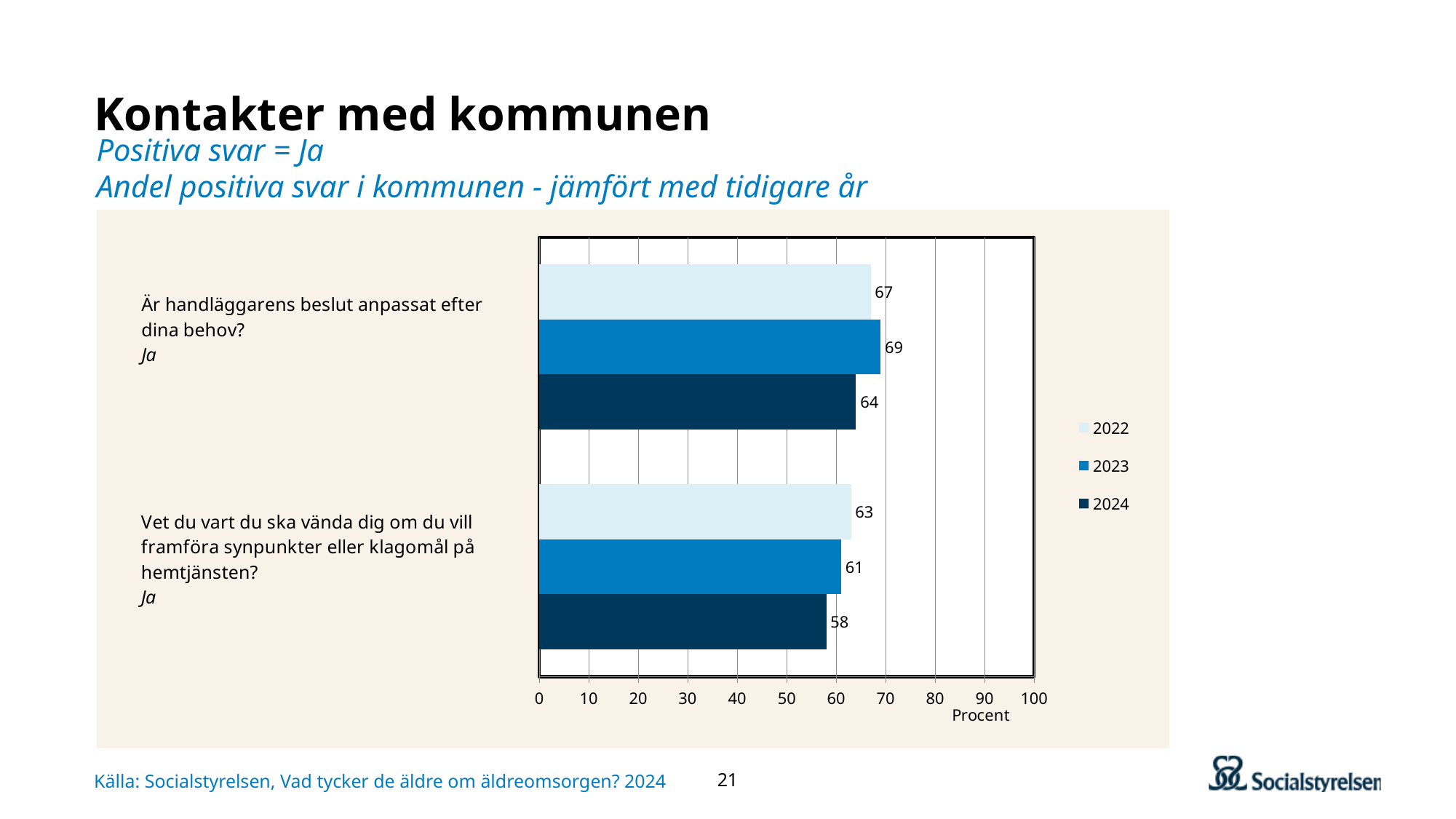
Which year has the lowest value for "Vet du vart du ska vända dig om du vill framföra synpunkter eller klagomål på hemtjänsten?"? 2024 What is the label on the horizontal axis of the chart? Procent What is the 2023 value for "Är handläggarens beslut anpassat efter dina behov?"? 69 What is the 2024 value for "Är handläggarens beslut anpassat efter dina behov?"? 64 What is the 2022 value for "Vet du vart du ska vända dig om du vill framföra synpunkter eller klagomål på hemtjänsten?"? 63 How many series does the legend list? 3 What is the difference between the 2022 and 2024 values for "Vet du vart du ska vända dig om du vill framföra synpunkter eller klagomål på hemtjänsten?"? 5 Which year has the highest value for "Är handläggarens beslut anpassat efter dina behov?"? 2023 What kind of chart is shown on the slide? Bar chart What is the difference between the 2023 and 2024 values for "Är handläggarens beslut anpassat efter dina behov?"? 5 Which is larger: the 2022 value for "Är handläggarens beslut anpassat efter dina behov?" or the 2022 value for "Vet du vart du ska vända dig om du vill framföra synpunkter eller klagomål på hemtjänsten?"? Är handläggarens beslut anpassat efter dina behov? How many questions (categories) are shown in the chart? 2